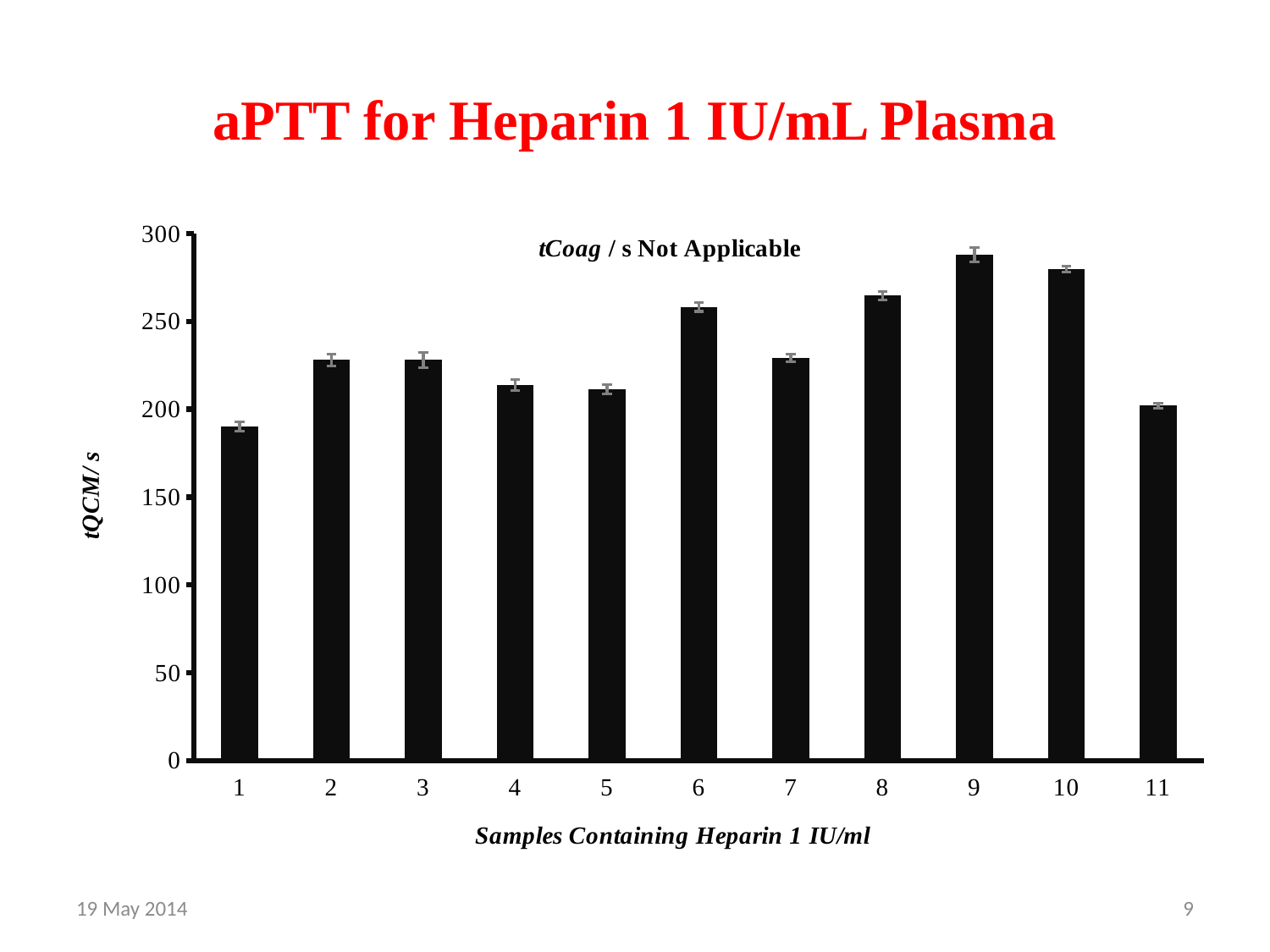
Is the value for sample 5 greater or less than 250? less Which has the larger tQCM / s value, sample 6 or sample 4? sample 6 Which sample has the highest tQCM / s value? 9 Is the value for sample 1 greater or less than 200? less What is the label of the x axis? Samples Containing Heparin 1 IU/ml What kind of chart is shown on the slide? bar chart How many samples are plotted along the x axis? 11 What is the title of the chart? aPTT for Heparin 1 IU/mL Plasma Is the value for sample 6 greater or less than 250? greater Which sample has the lowest tQCM / s value? 1